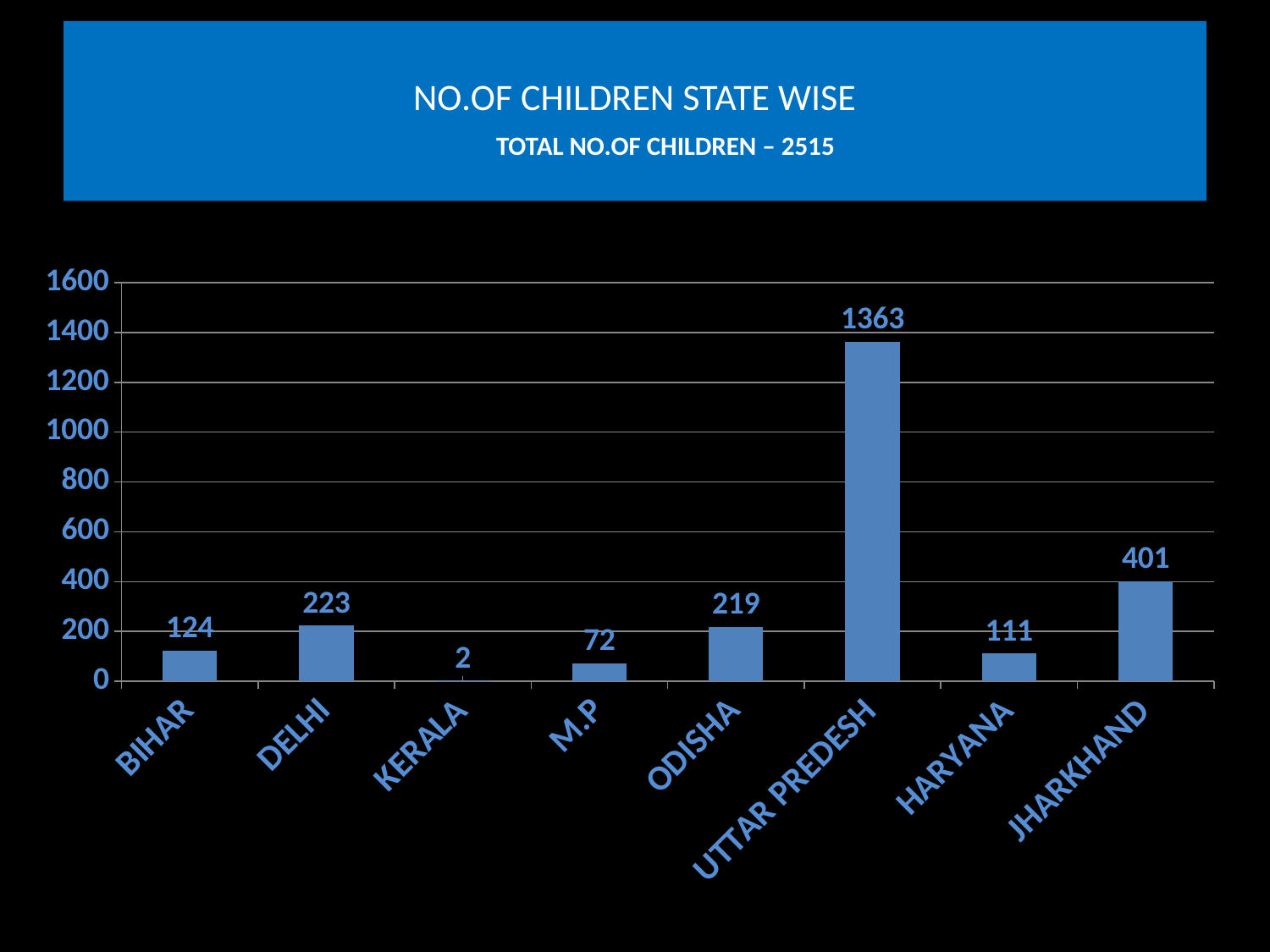
What is the number of children for Jharkhand? 401 Which has more children, Haryana or M.P? Haryana Is the value for Uttar Predesh greater or less than 1200? greater What kind of chart is shown on the slide? Bar chart How many states are shown on the chart? 8 Which state has the highest number of children? Uttar Predesh What is the number of children for Kerala? 2 Which state has the lowest number of children? Kerala What total number of children is stated in the slide title? 2515 What is the difference between the number of children for Jharkhand and Bihar? 277 What is the difference between the number of children for Delhi and Odisha? 4 What is the number of children for Uttar Predesh? 1363